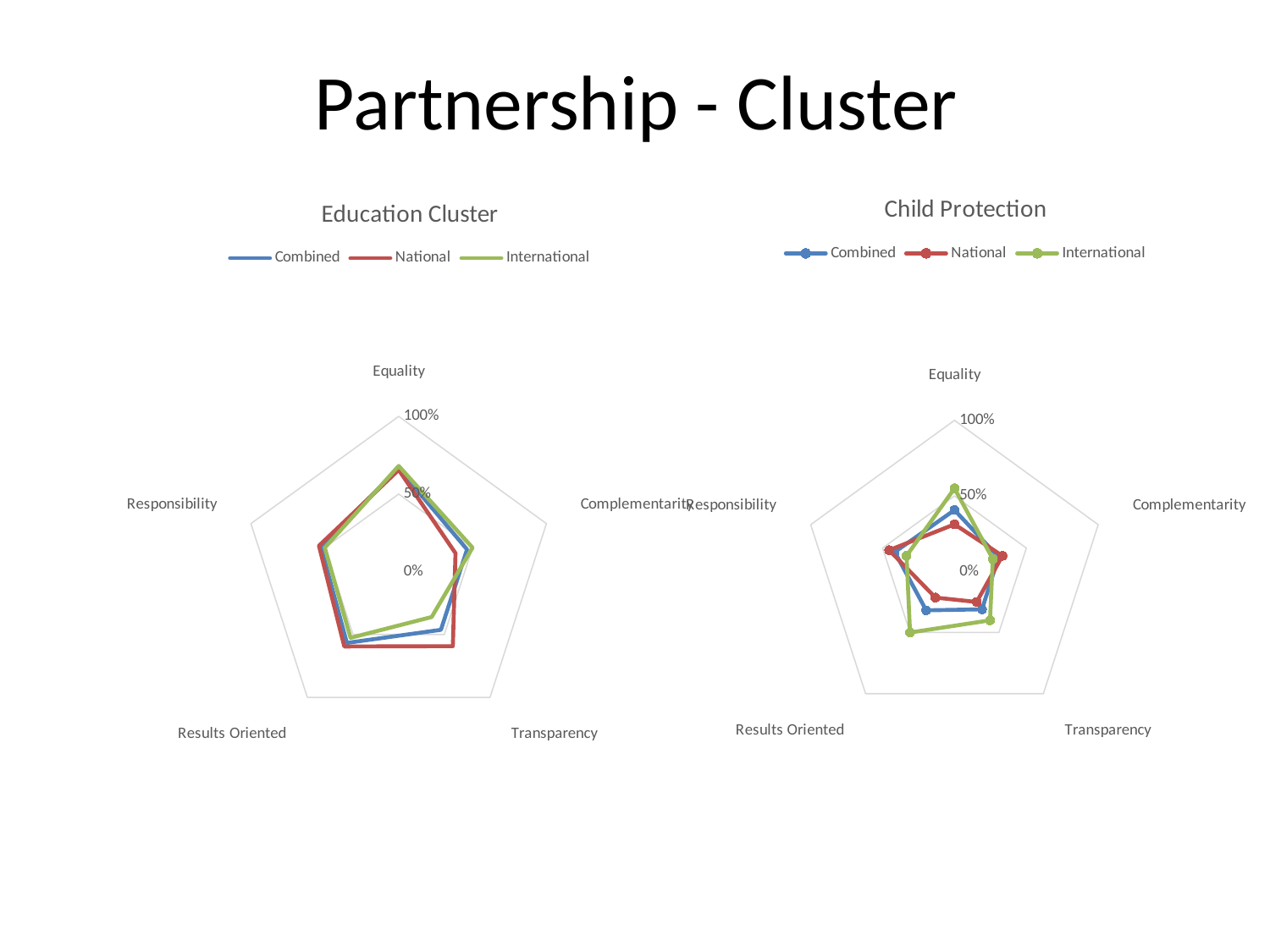
How many series does the legend of the Child Protection chart list? 3 In the Education Cluster chart, is the International value for Equality greater or less than 50%? greater In the Education Cluster chart, is the International value for Transparency greater or less than 50%? less In the Child Protection chart, which series has the higher value for Equality, International or National? International In the Child Protection chart, is the National value for Equality greater or less than 50%? less How many categories (axes) does the Education Cluster chart have? 5 In the Education Cluster chart, which series has the higher value for Transparency, National or International? National What kind of chart is the Education Cluster chart? Radar chart Which series is shown in red in the legend of the Education Cluster chart? National